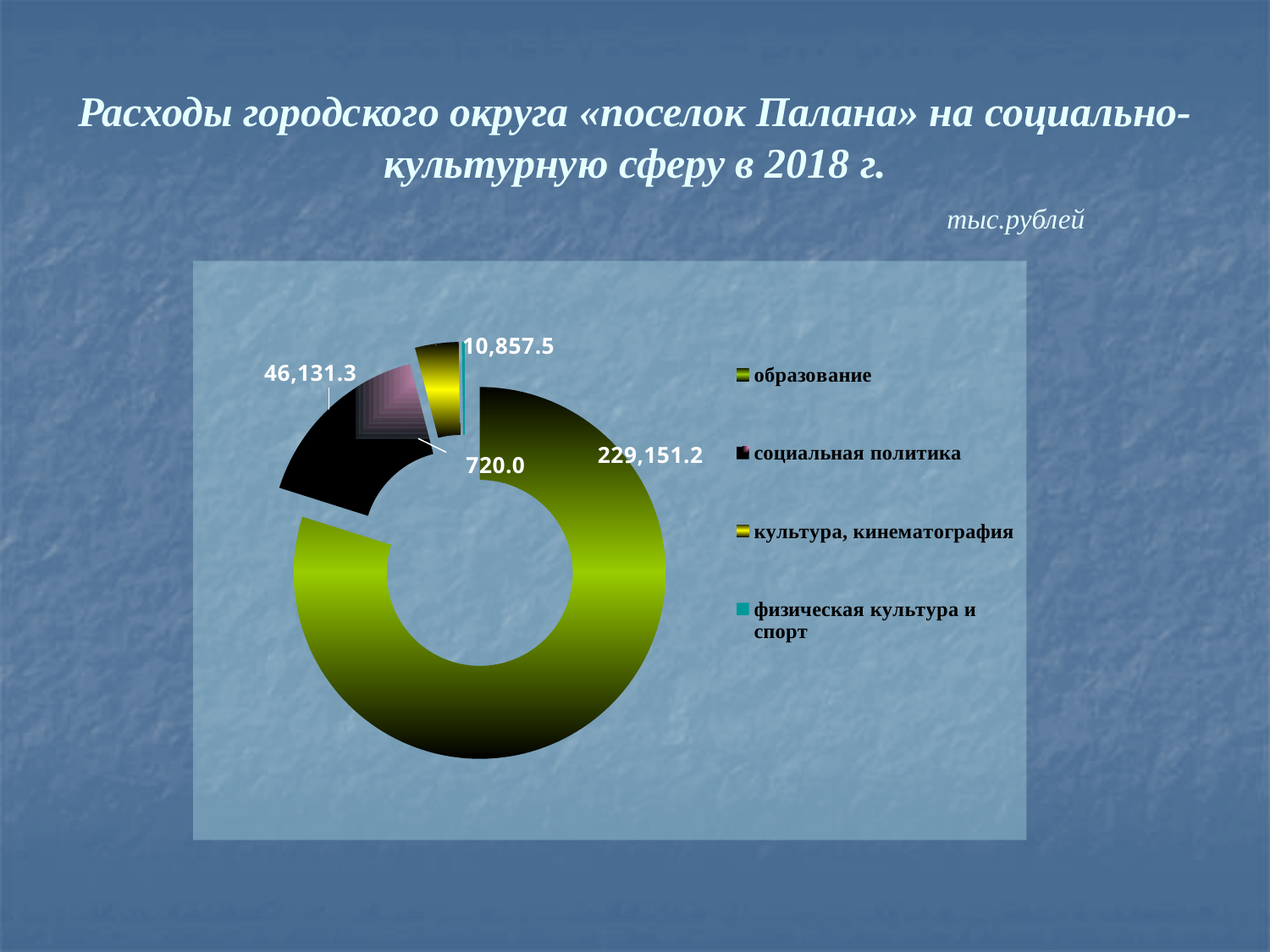
What is the difference between the values for культура, кинематография and физическая культура и спорт? 10,137.5 What type of chart is shown on the slide? doughnut chart What is the value for физическая культура и спорт? 720.0 What is the value for культура, кинематография? 10,857.5 What is the value for образование? 229,151.2 How many categories does the legend list? 4 What is the value for социальная политика? 46,131.3 In what units are the values on the chart given? тыс.рублей What is the difference between the values for образование and социальная политика? 183,019.9 Which is larger, the value for социальная политика or the value for культура, кинематография? социальная политика Which category has the smallest value? физическая культура и спорт Which category has the largest value? образование